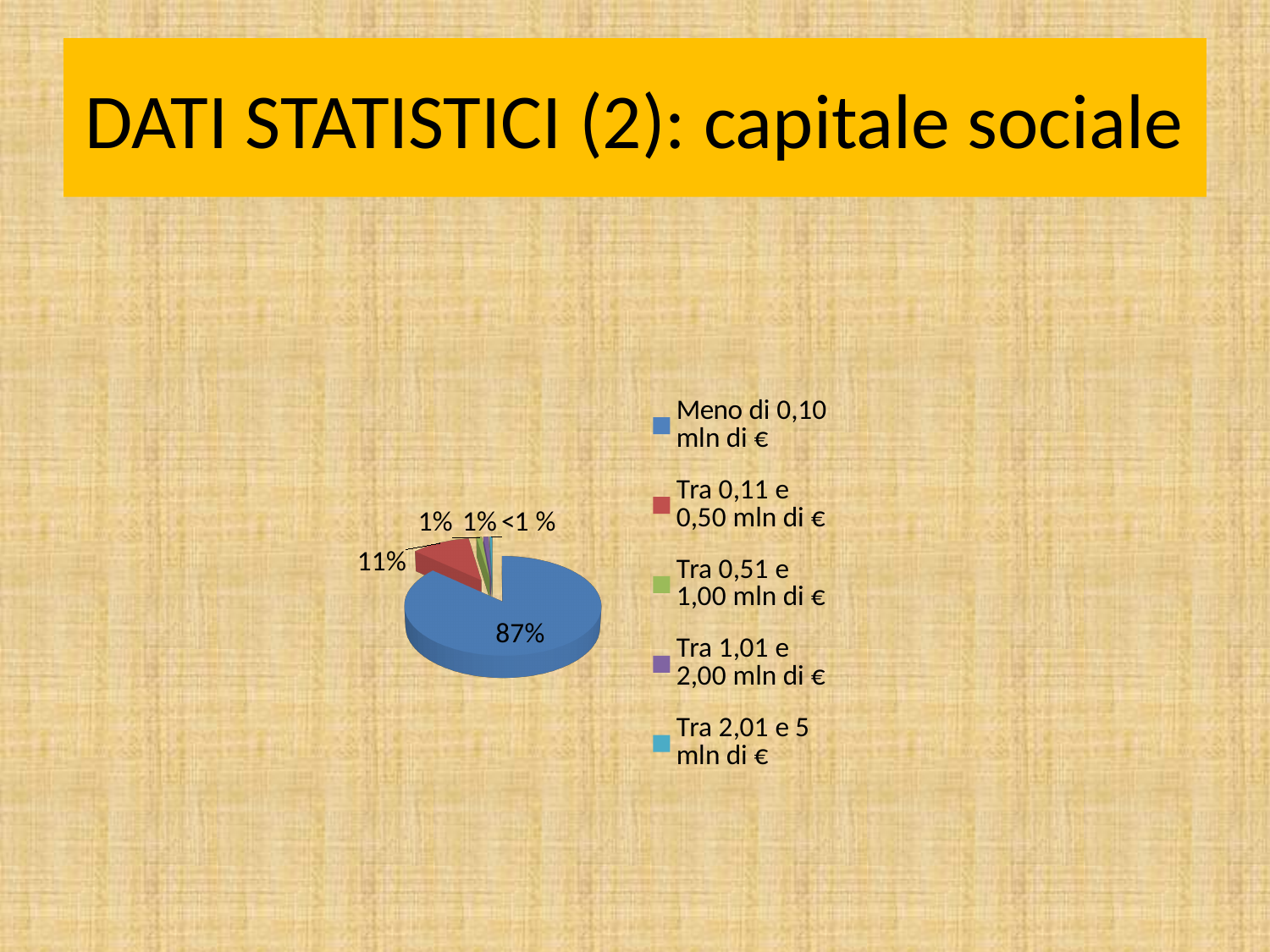
How many categories does the pie chart have? 5 What value is shown for the slice 'Tra 2,01 e 5 mln di €'? <1 % What percentage is shown for the slice 'Tra 0,11 e 0,50 mln di €'? 11% What colour is the largest slice of the pie chart? blue What percentage of the pie is the slice for 'Meno di 0,10 mln di €'? 87% What value is shown for the slice 'Tra 0,51 e 1,00 mln di €'? 1% Which category has the largest slice of the pie? Meno di 0,10 mln di € Which is larger: the slice for 'Meno di 0,10 mln di €' or the slice for 'Tra 0,11 e 0,50 mln di €'? Meno di 0,10 mln di € What is the title of the slide containing the pie chart? DATI STATISTICI (2): capitale sociale What kind of chart is shown on the slide? pie chart What is the difference in percentage points between the 'Meno di 0,10 mln di €' slice and the 'Tra 0,11 e 0,50 mln di €' slice? 76 percentage points Which category has the smallest slice of the pie? Tra 2,01 e 5 mln di €